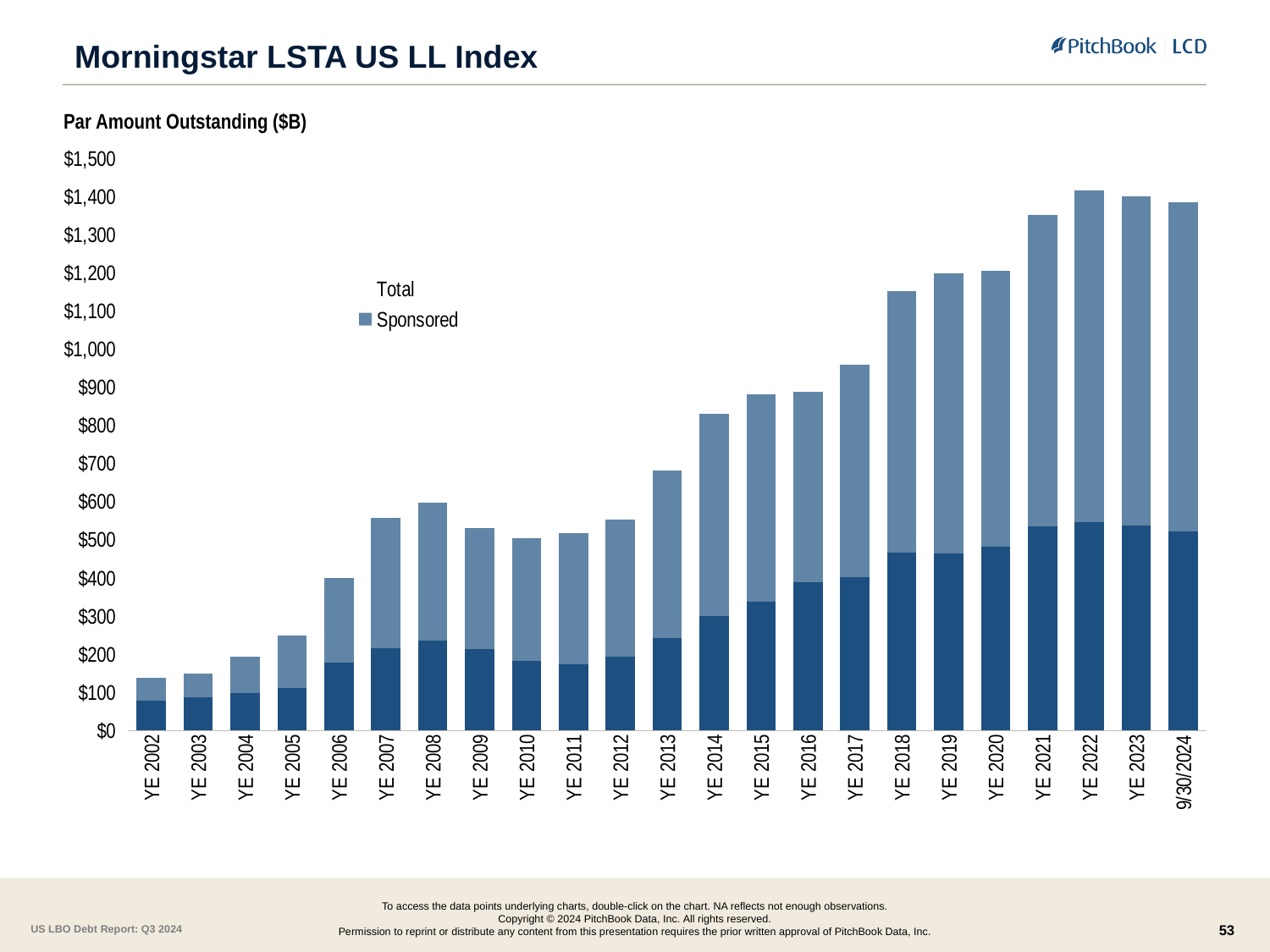
Which has the larger Total value, YE 2008 or YE 2009? YE 2008 Do the Total values rise or fall from YE 2002 to YE 2008? Rise Which has the larger Total value, YE 2012 or YE 2013? YE 2013 Is the Sponsored value for YE 2021 greater or less than $500? greater Is the Sponsored value for YE 2014 greater or less than $400? greater Is the Total value for YE 2006 greater or less than $500? less What are the two series named in the legend? Total and Sponsored How many series does the legend list? 2 What is the label above the chart describing what is plotted? Par Amount Outstanding ($B) How many time periods are shown along the x axis? 23 What kind of chart is shown on the slide? Bar chart